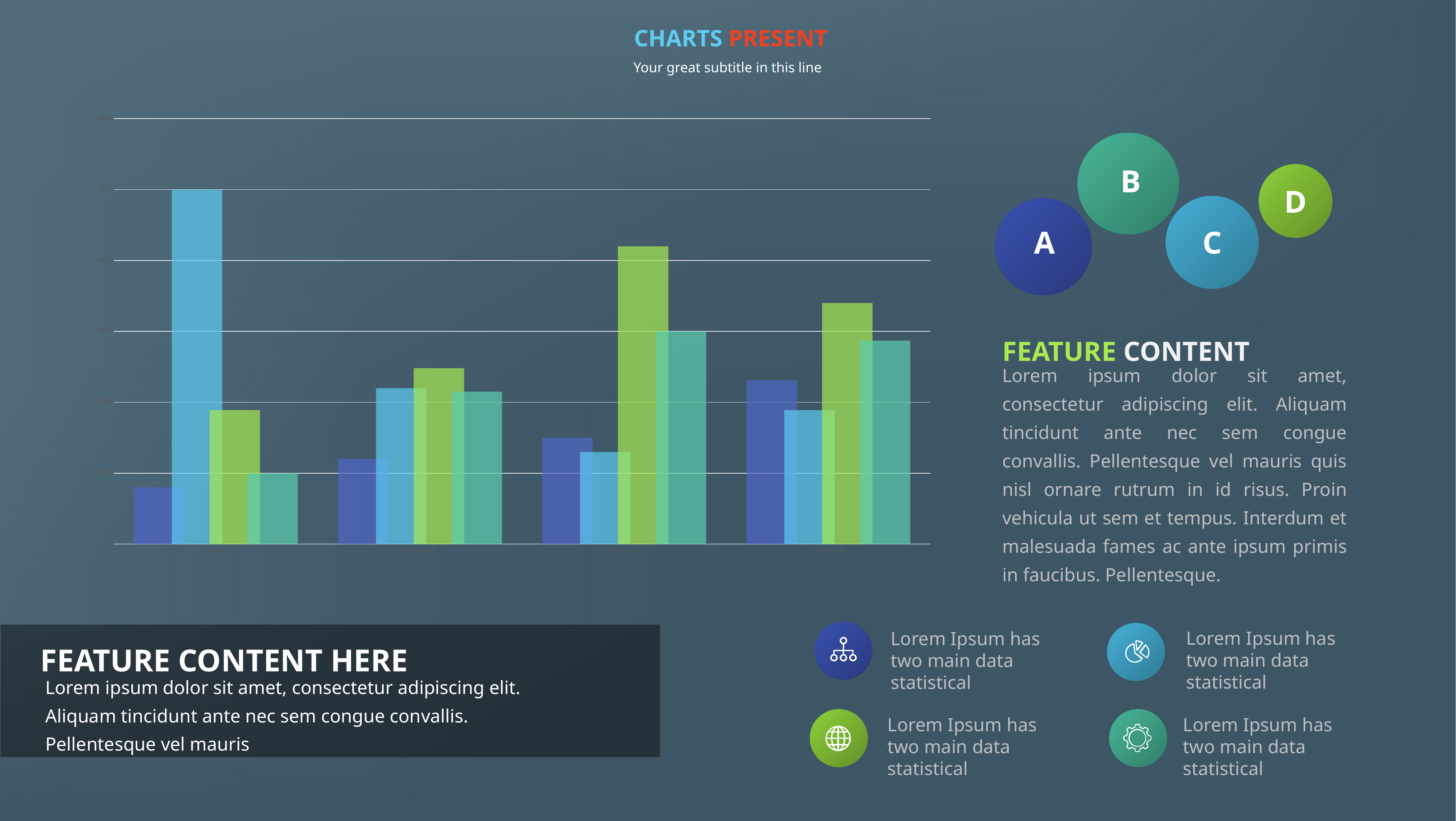
What is the title of the slide containing the chart? CHARTS PRESENT Do the dark blue bars rise or fall from the first group to the fourth group? rise What is the value of the tallest bar in the first group from the left? 500 Is the value of the green bar in Group 4 greater or less than 300? greater What is the value of the teal bar in Group 3? 300 Is the value of the green bar in Group 3 greater or less than 400? greater How many bars are there in each group? 4 How many groups of bars are plotted along the x axis? 4 What kind of chart is shown on the slide? bar chart Is the value of the light blue bar in Group 3 greater or less than 200? less In Group 3, which is larger, the green bar or the teal bar? green bar What is the highest value labelled on the vertical axis? 600